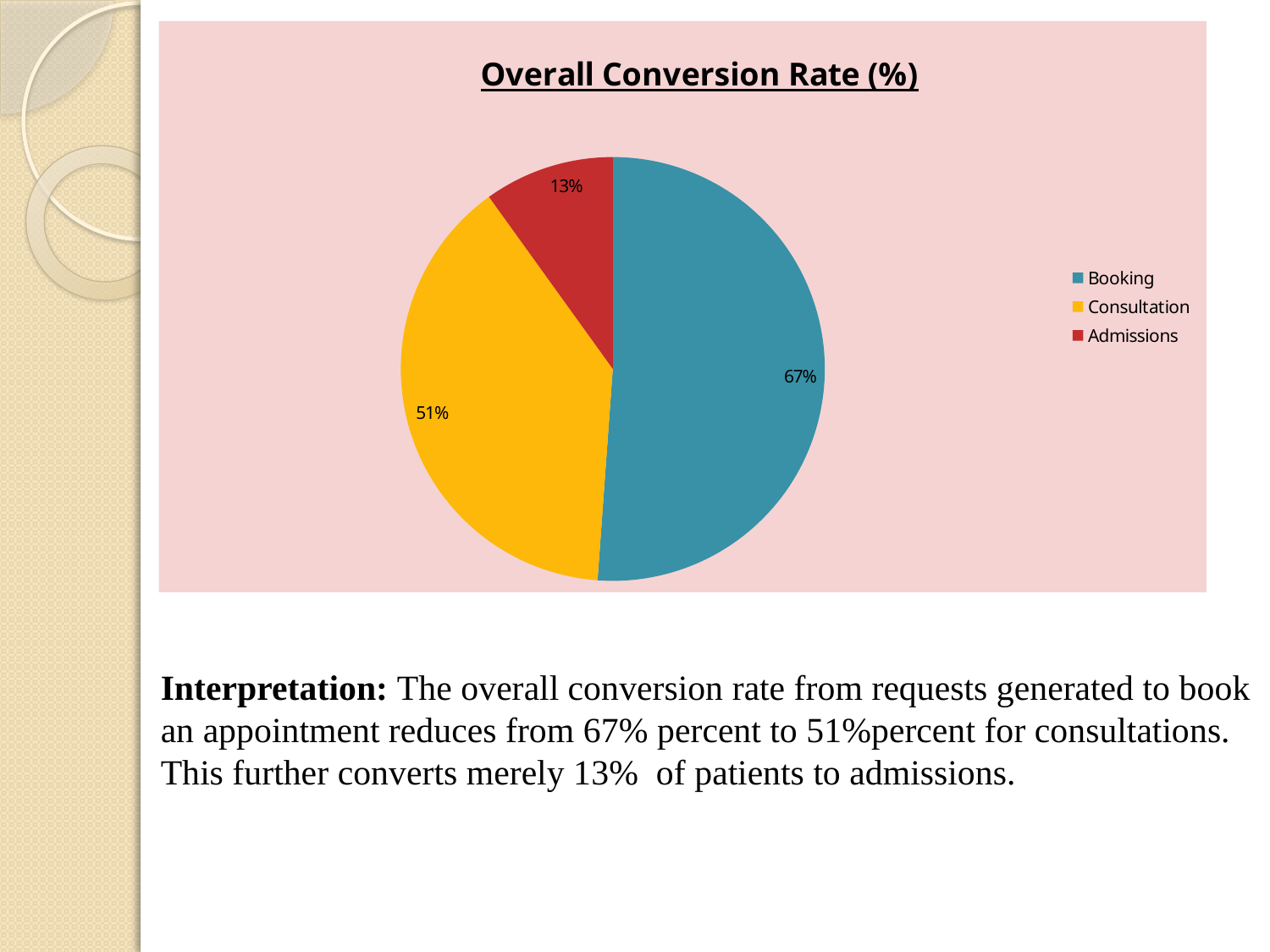
Which category has the highest value? Booking What type of chart is shown on the slide? Pie chart What value is shown for Booking? 67% Which is larger, the value for Consultation or the value for Admissions? Consultation How many entries does the legend list? 3 What is the difference between the Consultation value and the Admissions value? 38% What value is shown for Admissions? 13% Which category has the lowest value? Admissions What value is shown for Consultation? 51% How many categories does the pie chart show? 3 What is the difference between the Booking value and the Consultation value? 16% What is the title of the chart? Overall Conversion Rate (%)